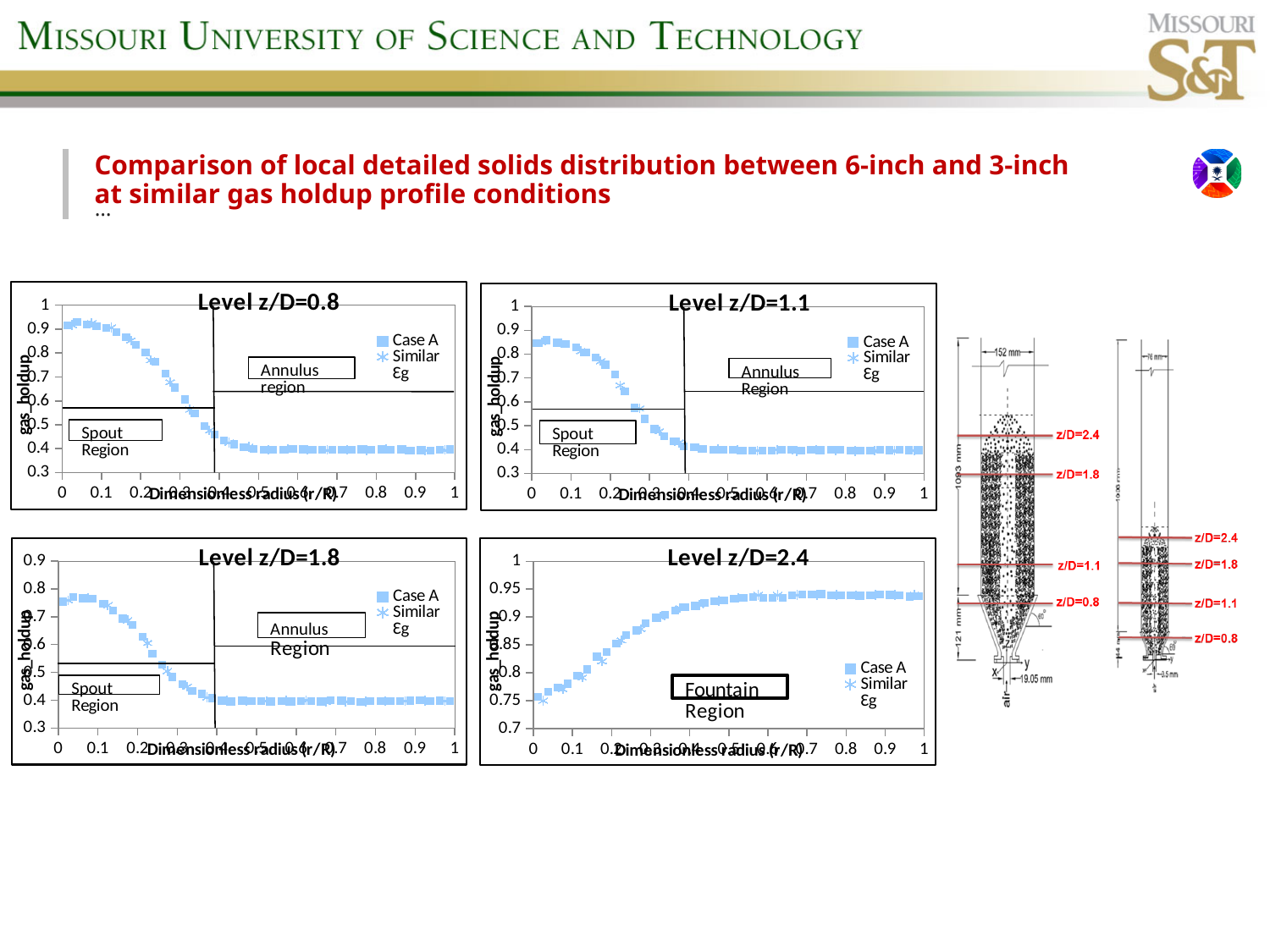
In the chart titled "Level z/D=1.1", is the gas holdup value at dimensionless radius 0.9 greater or less than 0.5? less In the chart titled "Level z/D=1.8", is the gas holdup value at dimensionless radius 0.1 greater or less than 0.7? greater What kind of chart is the chart titled "Level z/D=2.4"? scatter chart In the chart titled "Level z/D=0.8", is the gas holdup value at dimensionless radius 0.9 greater or less than 0.5? less How many series does the legend list in the chart titled "Level z/D=1.1"? 2 In the chart titled "Level z/D=2.4", do the gas holdup values rise or fall as the dimensionless radius increases? rise In the chart titled "Level z/D=0.8", do the gas holdup values rise or fall as the dimensionless radius increases? fall